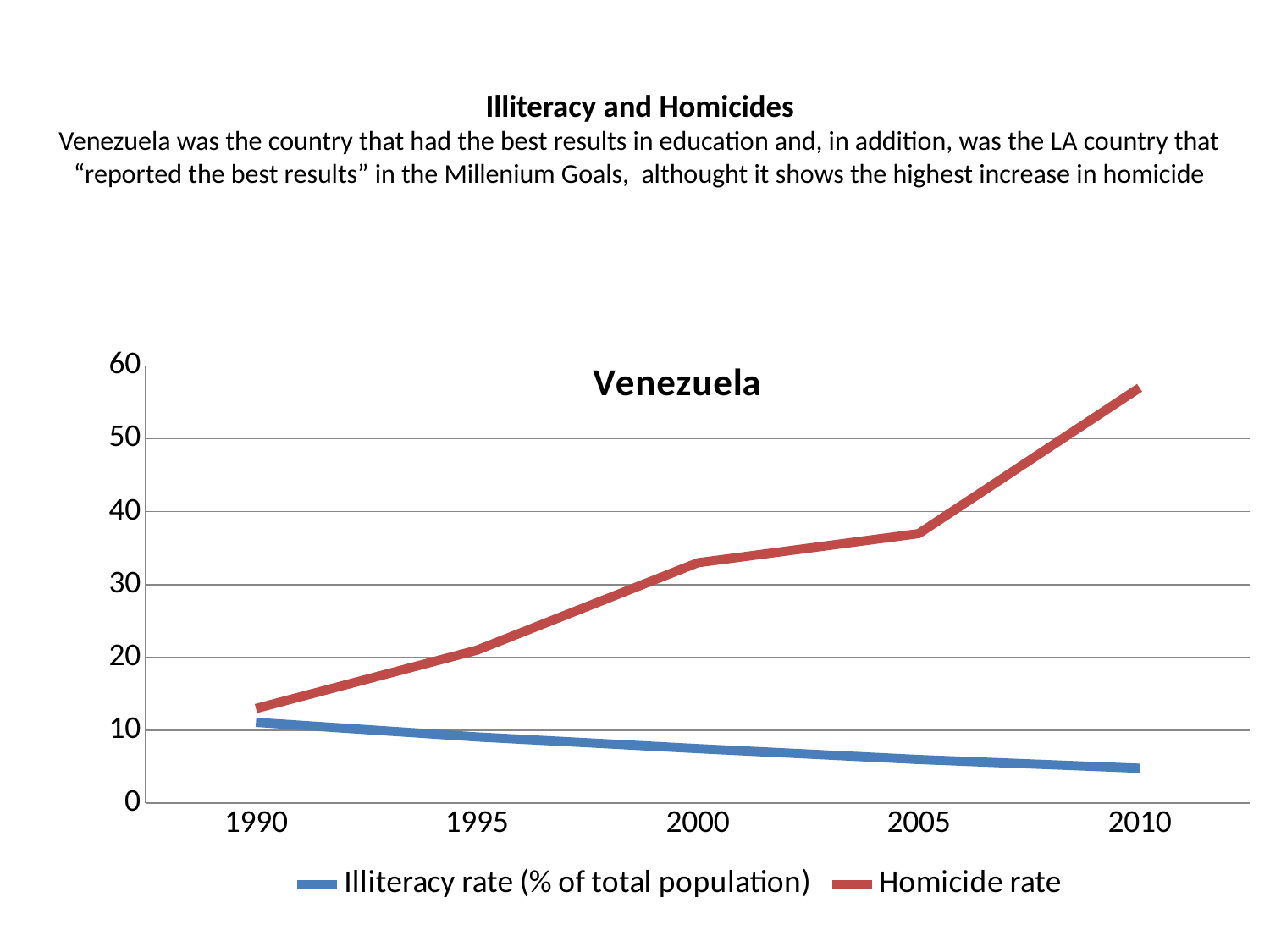
What kind of chart is shown on the slide? line chart Is the Illiteracy rate (% of total population) in 2010 greater or less than 10? less What is the title of the chart? Venezuela In which year is the Homicide rate lowest? 1990 Which series is drawn in red on the chart? Homicide rate Is the Homicide rate in 2010 greater or less than 50? greater In which year is the Illiteracy rate (% of total population) highest? 1990 Does the Homicide rate rise or fall from 1990 to 2010? rise Does the Illiteracy rate (% of total population) rise or fall from 1990 to 2010? fall In which year is the Homicide rate highest? 2010 How many years are plotted along the x axis of the chart? 5 How many series does the chart legend list? 2